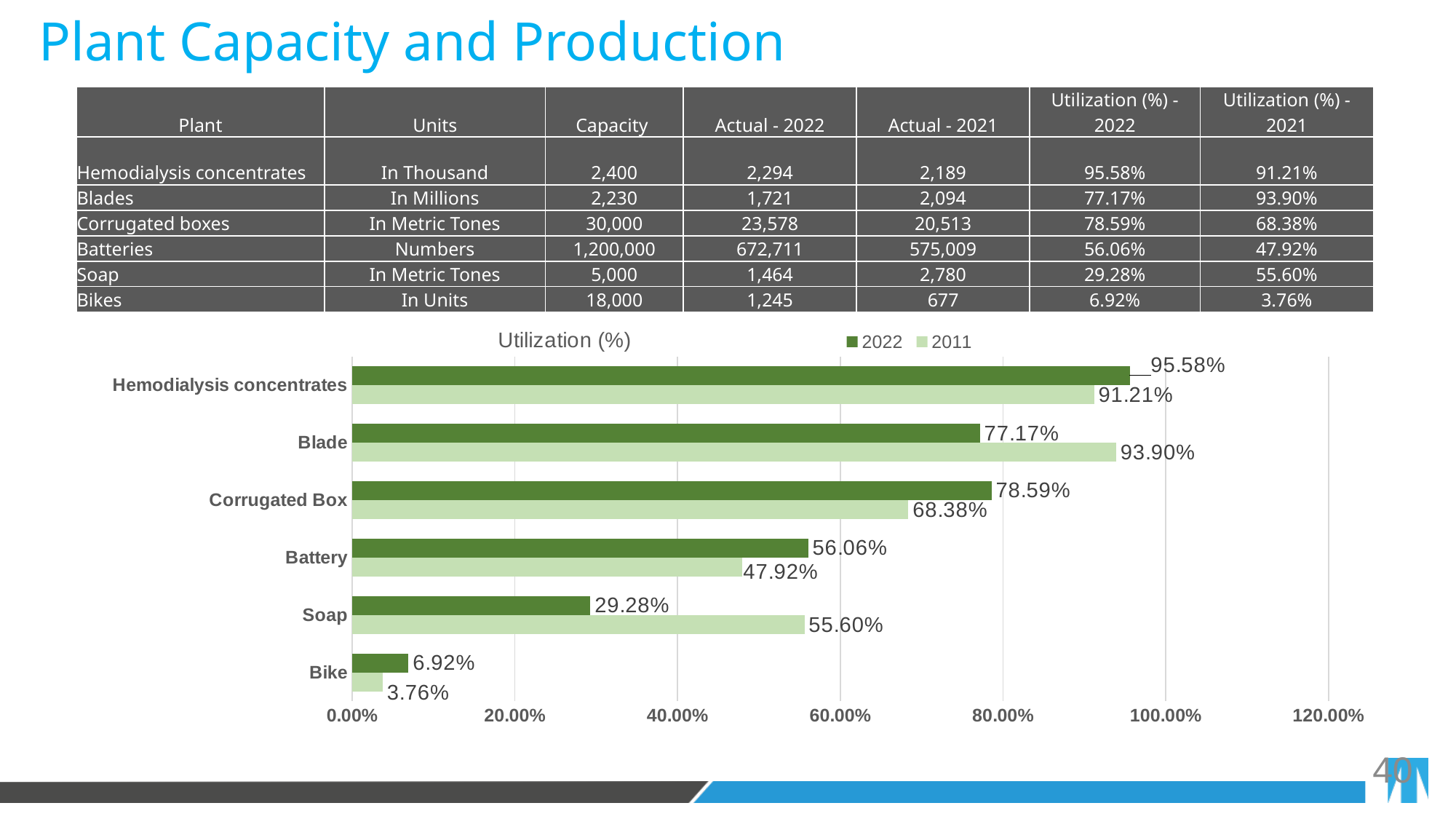
What is the 2011 series value for Soap in the chart? 55.60% What type of chart is shown on the slide? Bar chart What is the 2022 utilization value for Corrugated Box in the chart? 78.59% Is the 2022 value for Battery in the chart greater or less than 40.00%? greater Which category has the lowest 2011 series value in the chart? Bike Which category has the highest 2022 value in the chart? Hemodialysis concentrates What is the difference between the 2022 and 2011 values for Bike in the chart? 3.16% What is the difference between the 2011 and 2022 values for Blade in the chart? 16.73% What is the title of the chart? Utilization (%) How many categories are plotted on the chart? 6 How many series does the chart legend list? 2 For Soap, which is larger in the chart: the 2022 value or the 2011 value? 2011